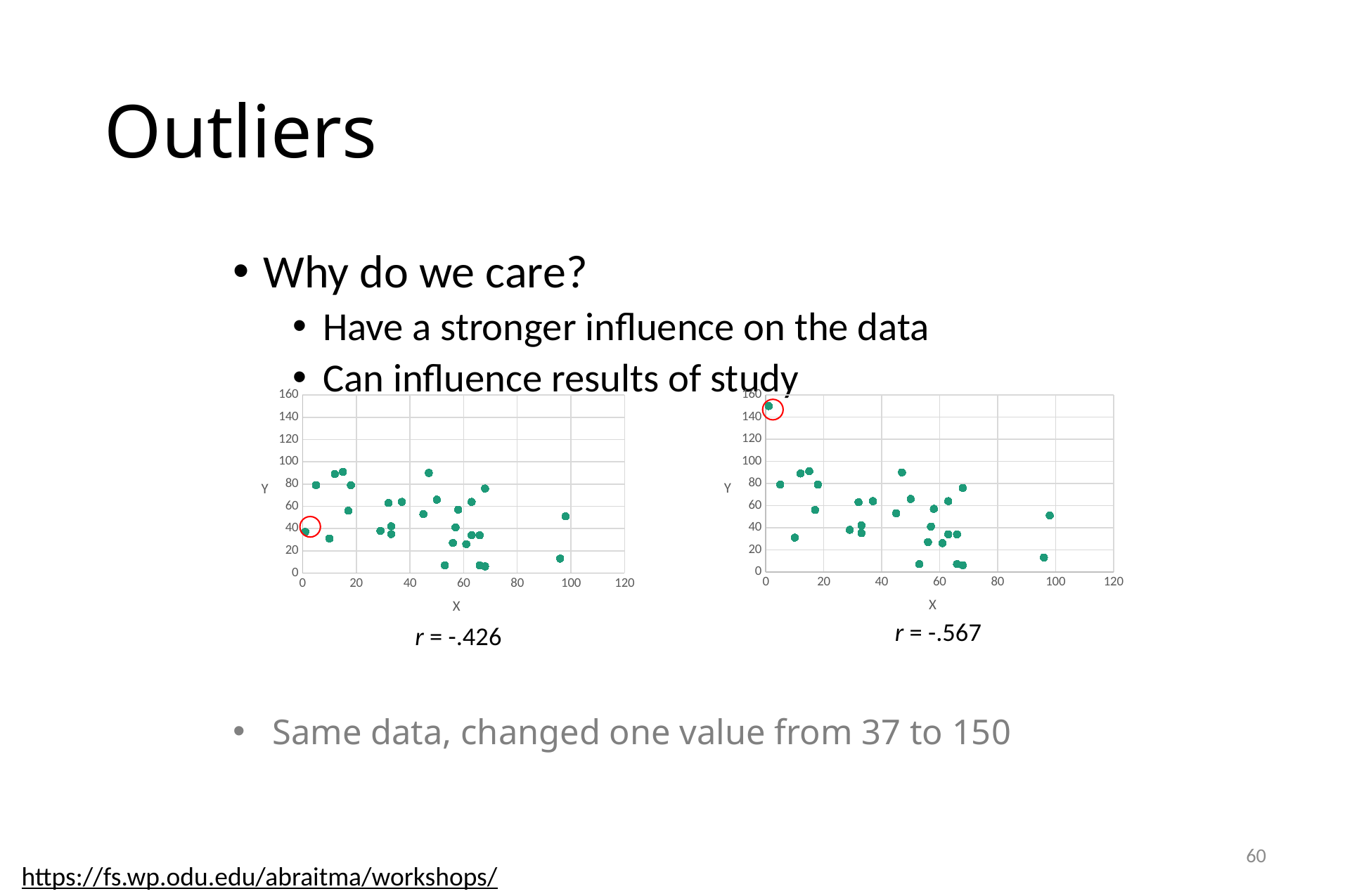
In the left chart, is the Y value of the point with the largest X value (near X = 100) greater or less than 40? greater In the left chart, is the Y value of the circled point greater or less than 60? less Which chart has the point with the highest Y value, the left chart or the right chart? the right chart In the left chart, is the Y value of the point near X = 96 greater or less than 20? less What is the maximum value shown on the X axis of the right chart? 120 In the right chart, do the Y values generally rise or fall as X increases? fall What kind of chart is the right chart? scatter plot What is the maximum value shown on the Y axis of the left chart? 160 What kind of chart is the left chart? scatter plot